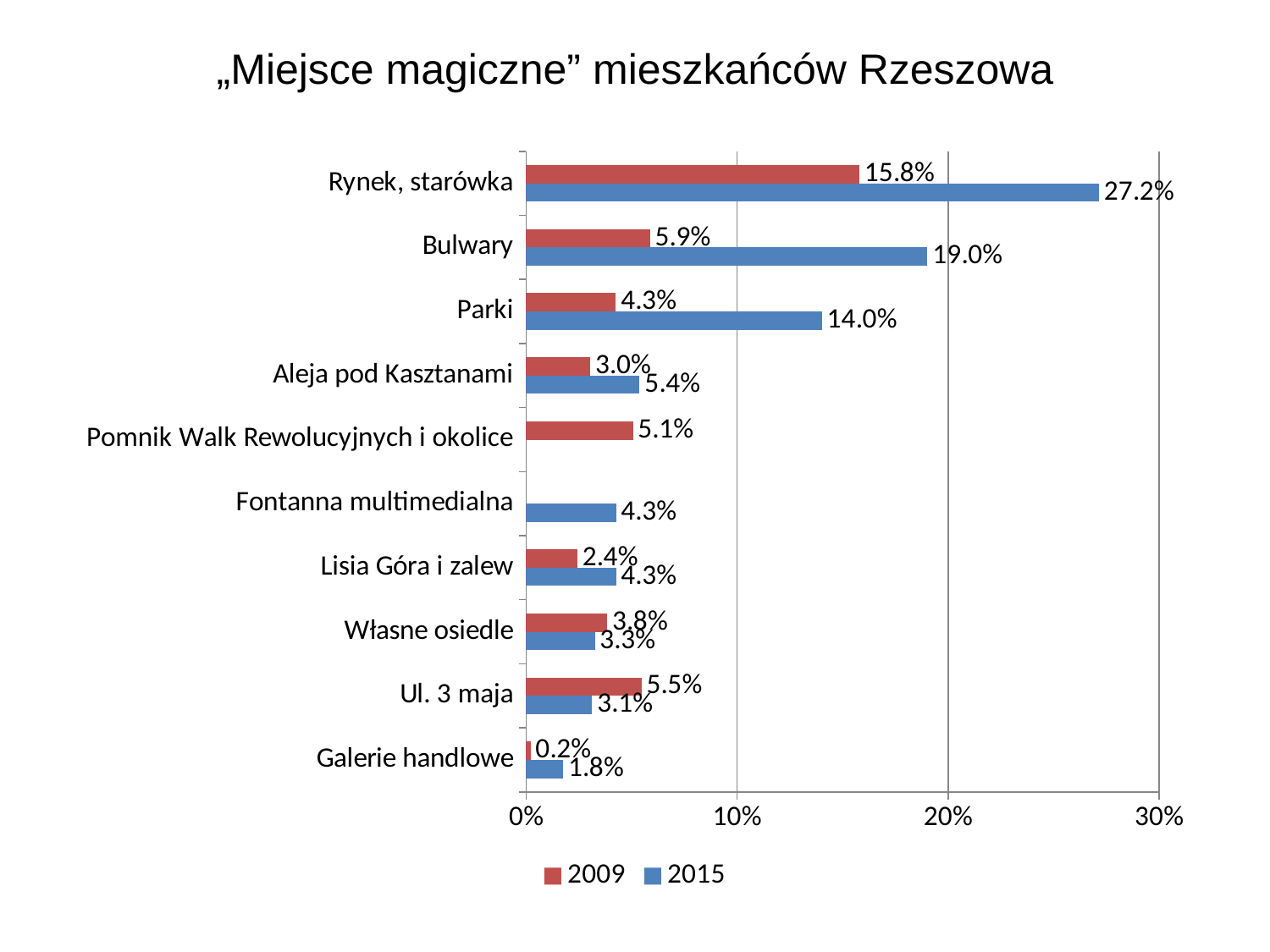
What is the difference between the 2015 and 2009 values for Bulwary? 13.1% What kind of chart is shown on the slide? bar chart What is the 2015 value for Rynek, starówka? 27.2% Which category has the lowest 2009 value? Galerie handlowe Which category has the highest 2015 value? Rynek, starówka What is the 2015 value for Parki? 14.0% What is the 2009 value for Bulwary? 5.9% How many categories are shown on the chart? 10 How many series does the legend list? 2 What is the 2009 value for Pomnik Walk Rewolucyjnych i okolice? 5.1% Is the 2015 value for Rynek, starówka greater or less than 20%? greater Which is larger for Ul. 3 maja, the 2009 value or the 2015 value? 2009